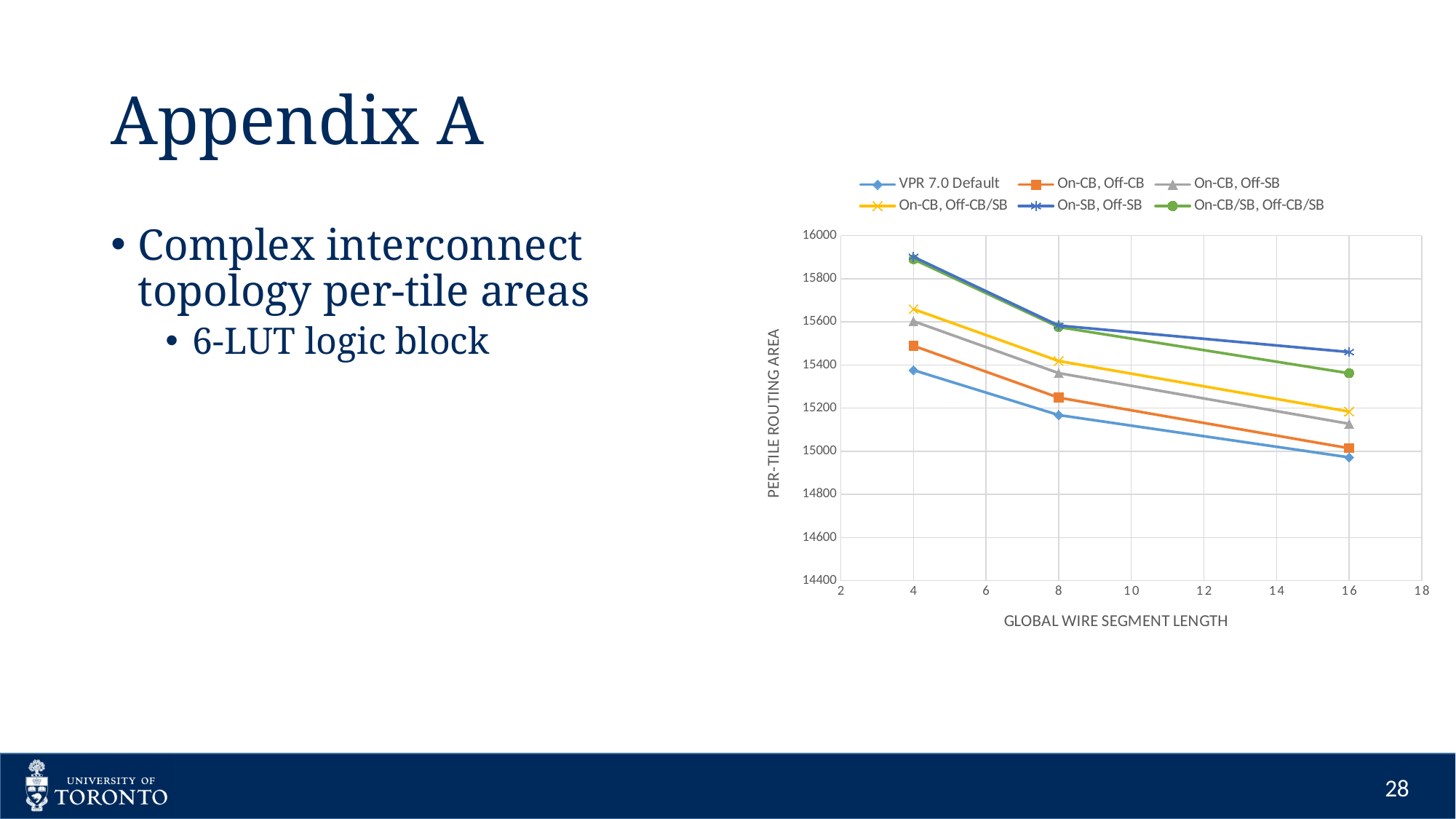
Is the value for On-CB/SB, Off-CB/SB at global wire segment length 16 greater or less than 15200? greater Does the per-tile routing area for VPR 7.0 Default rise or fall as global wire segment length increases? fall Which series has the highest per-tile routing area at global wire segment length 16? On-SB, Off-SB What kind of chart is shown on the slide? line chart What is the title of the vertical axis? PER-TILE ROUTING AREA How many data points are plotted for the VPR 7.0 Default series? 3 Is the value for VPR 7.0 Default at global wire segment length 16 greater or less than 15000? less Is the value for On-CB, Off-CB at global wire segment length 8 greater or less than 15200? greater Which series has the lowest per-tile routing area at global wire segment length 4? VPR 7.0 Default How many series does the legend list? 6 At global wire segment length 8, which is larger: On-CB, Off-CB or On-CB, Off-SB? On-CB, Off-SB